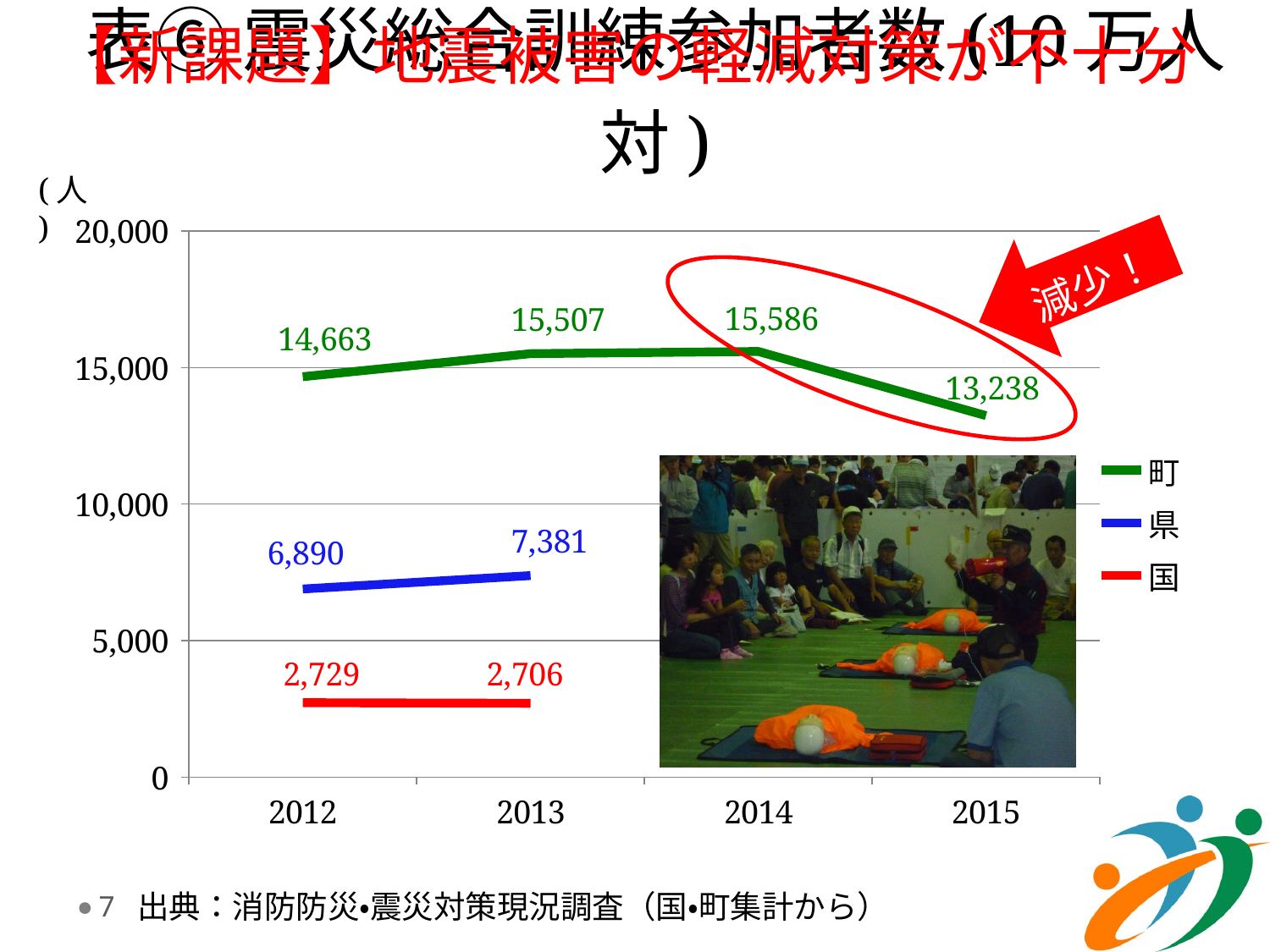
Does the 町 series rise or fall from 2014 to 2015? fall What is the difference between the 町 values for 2014 and 2015? 2,348 What type of chart is shown on the slide? line chart What is the value for 町 in 2015? 13,238 What is the value for 県 in 2013? 7,381 What is the value for 町 in 2012? 14,663 In which year is the value for 町 lowest? 2015 How many series does the legend list? 3 Which is larger, the 県 value in 2012 or the 県 value in 2013? 2013 What colour is the line for 国? red What is the value for 国 in 2012? 2,729 In which year is the value for 町 highest? 2014